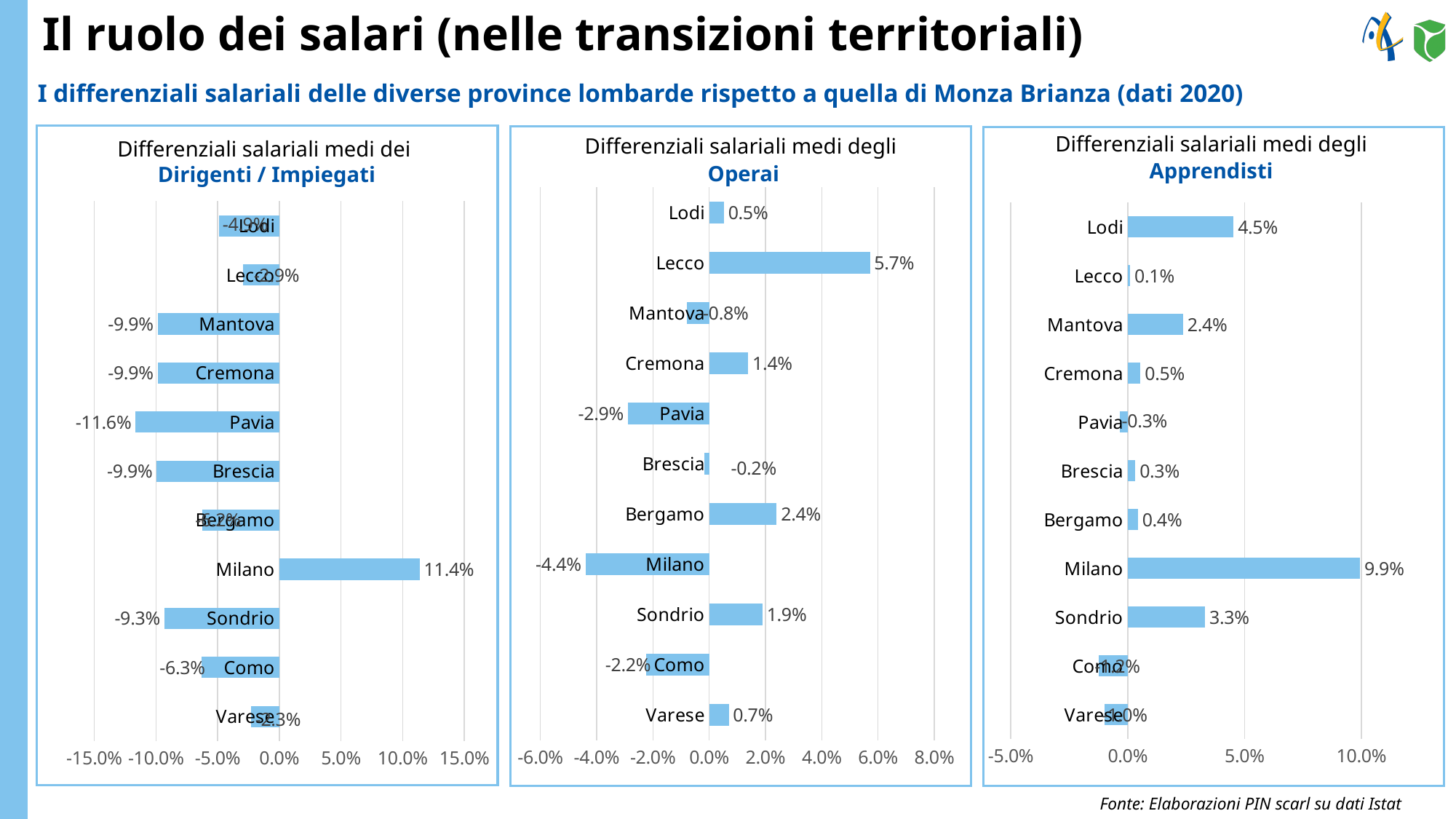
What type of chart is used in the 'Operai' panel? Bar chart In the 'Operai' chart, how many provinces are shown? 11 In the 'Dirigenti / Impiegati' chart, which province has the lowest value? Pavia In the 'Apprendisti' chart, what is the value for Milano? 9.9% In the 'Dirigenti / Impiegati' chart, what is the value for Pavia? -11.6% In the 'Operai' chart, which province has the lowest value? Milano In the 'Apprendisti' chart, what is the difference between the values for Milano and Lodi? 5.4% In the 'Dirigenti / Impiegati' chart, which province has the highest value? Milano In the 'Operai' chart, what is the difference between the values for Bergamo and Sondrio? 0.5% In the 'Operai' chart, what is the value for Lecco? 5.7% In the 'Apprendisti' chart, which is larger, the value for Lodi or the value for Sondrio? Lodi In the 'Dirigenti / Impiegati' chart, what is the value for Milano? 11.4%